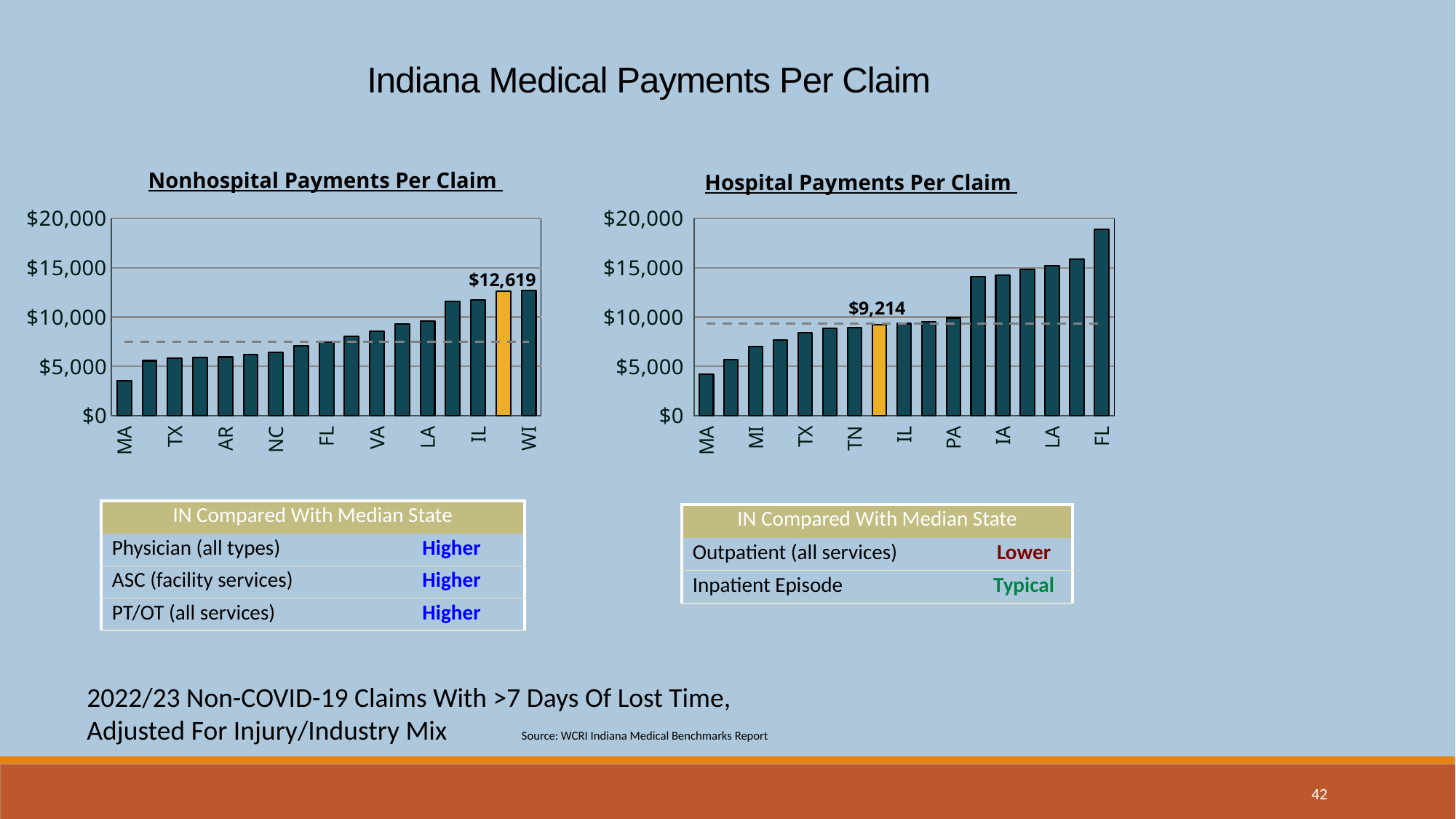
In the Hospital Payments Per Claim chart, is the value for FL greater or less than $15,000? greater In the Nonhospital Payments Per Claim chart, which labeled state has the highest value? WI What is the title of the chart on the left side of the slide? Nonhospital Payments Per Claim In the Hospital Payments Per Claim chart, which labeled state has the lowest value? MA In the Hospital Payments Per Claim chart, which is larger, the value for FL or the value for TX? FL What kind of chart is the Nonhospital Payments Per Claim chart? bar chart In the Nonhospital Payments Per Claim chart, what value is printed on the highlighted (yellow) bar? $12,619 In the Nonhospital Payments Per Claim chart, which is larger, the value for IL or the value for MA? IL How many state labels are shown on the x axis of the Hospital Payments Per Claim chart? 9 In the Hospital Payments Per Claim chart, what value is printed on the highlighted (yellow) bar? $9,214 In the Hospital Payments Per Claim chart, do the values rise or fall from left to right along the x axis? rise In the Nonhospital Payments Per Claim chart, is the value for MA greater or less than $5,000? less